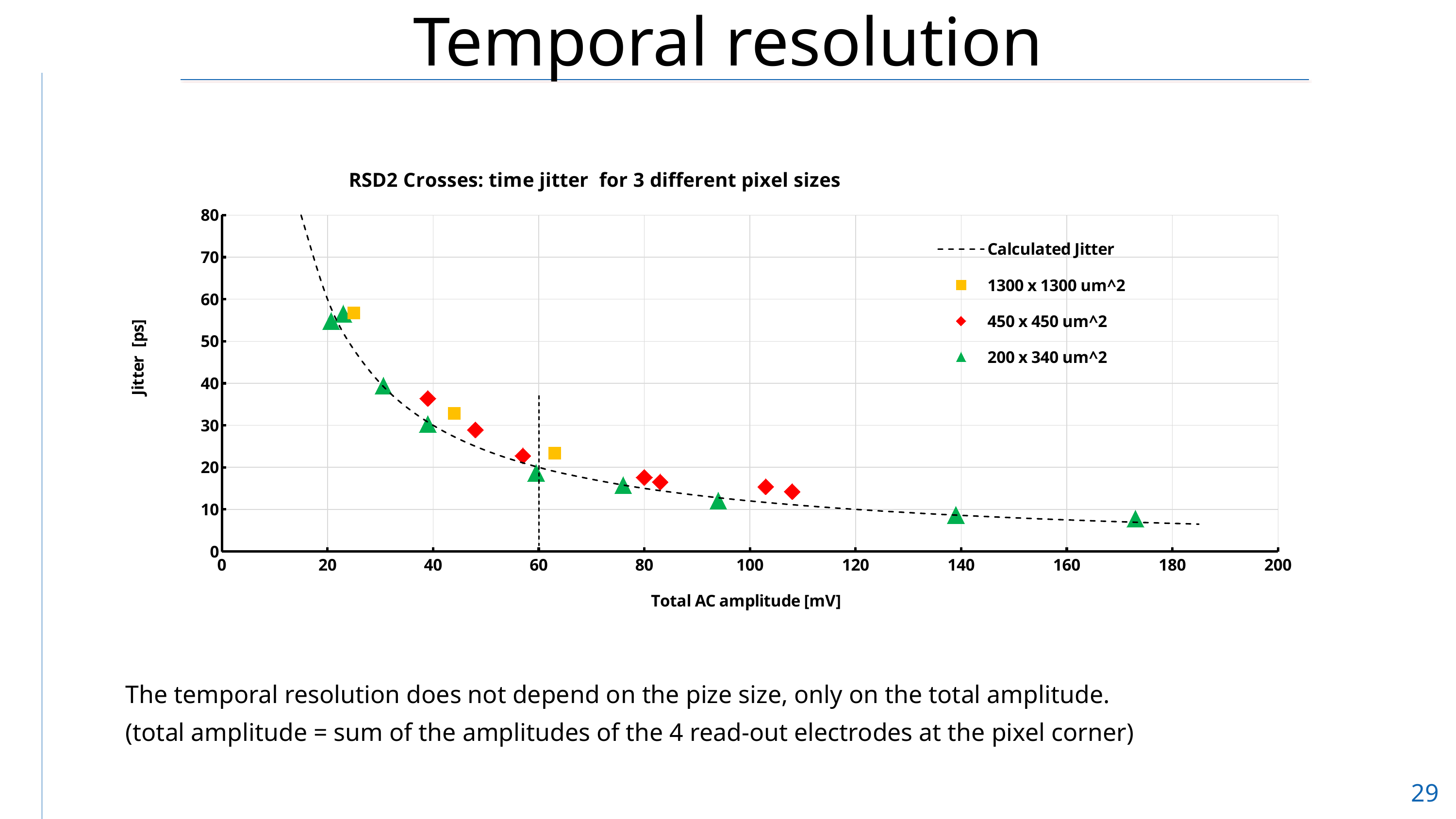
How many different pixel sizes are plotted as data series in the chart? 3 How many data points are plotted for the 450 x 450 um^2 series? 7 How many data points are plotted for the 1300 x 1300 um^2 series? 3 What is the label of the x axis? Total AC amplitude [mV] Is the jitter of the 450 x 450 um^2 point at the lowest amplitude (around 39 mV) greater or less than 30 ps? greater As the total AC amplitude increases along the x axis, does the jitter rise or fall? Fall Is the jitter of the 1300 x 1300 um^2 point at the lowest amplitude (around 25 mV) greater or less than 50 ps? greater How many entries does the chart legend list? 4 What is the title of the chart? RSD2 Crosses: time jitter for 3 different pixel sizes Which series contains the data point with the highest total AC amplitude? 200 x 340 um^2 What kind of chart is shown on the slide? Scatter chart Is the jitter of the 200 x 340 um^2 point at the highest amplitude (around 173 mV) greater or less than 10 ps? less